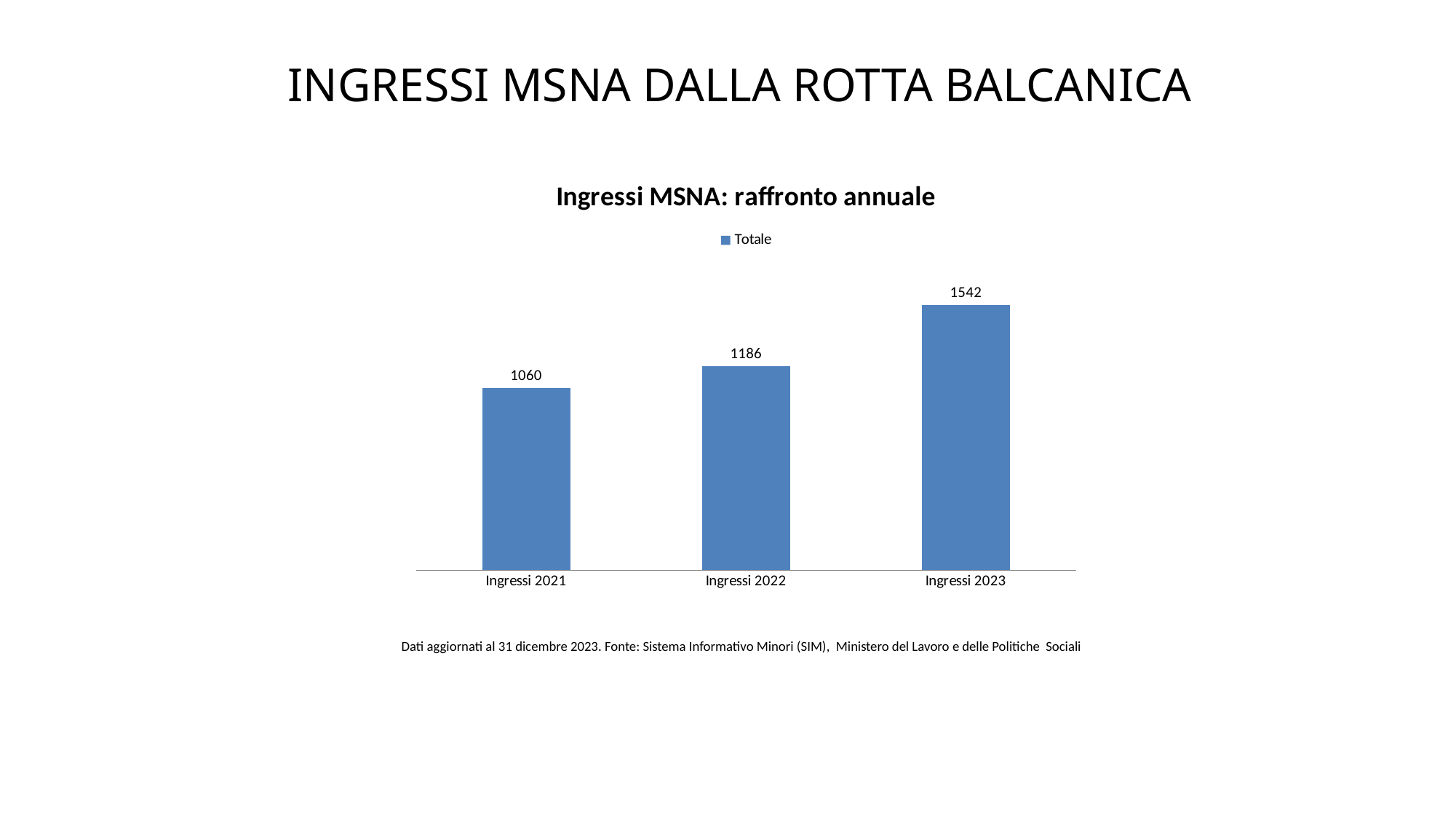
What is the difference between the values for Ingressi 2023 and Ingressi 2021? 482 Which category has the lowest value? Ingressi 2021 How many categories are shown on the x axis? 3 How many series does the legend list? 1 Which category has the highest value? Ingressi 2023 Do the values rise or fall from Ingressi 2021 to Ingressi 2023? rise Which is larger, the value for Ingressi 2022 or Ingressi 2023? Ingressi 2023 What kind of chart is shown? bar chart What is the difference between the values for Ingressi 2022 and Ingressi 2021? 126 What is the value for Ingressi 2023? 1542 What is the value for Ingressi 2022? 1186 What is the value for Ingressi 2021? 1060